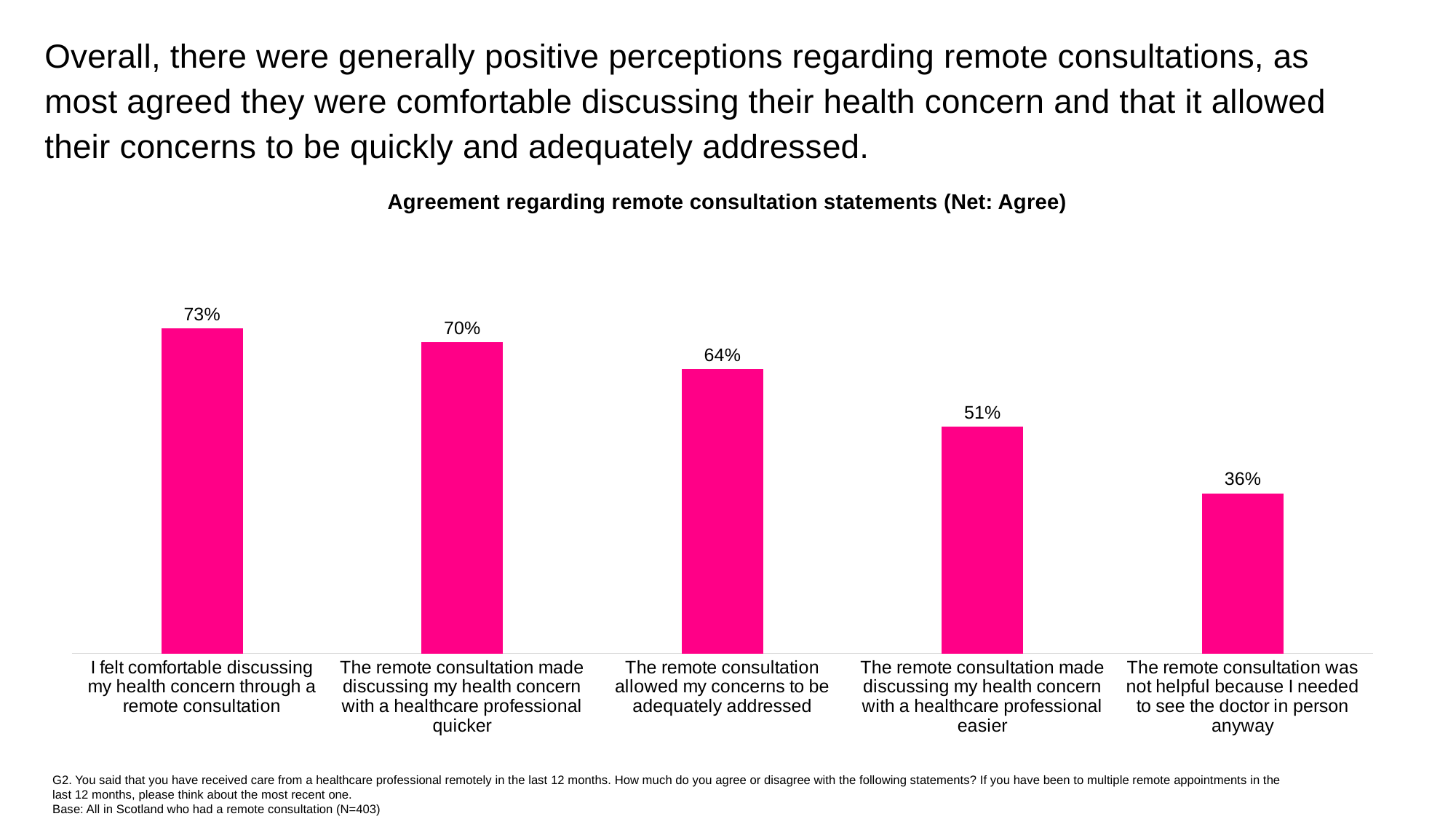
Which statement has the lowest net agreement? The remote consultation was not helpful because I needed to see the doctor in person anyway Which has higher net agreement: 'The remote consultation allowed my concerns to be adequately addressed' or 'The remote consultation made discussing my health concern with a healthcare professional easier'? The remote consultation allowed my concerns to be adequately addressed What is the title of the chart? Agreement regarding remote consultation statements (Net: Agree) What is the difference between the highest and lowest net agreement values in the chart? 37 percentage points What is the difference in net agreement between 'The remote consultation made discussing my health concern with a healthcare professional quicker' and 'The remote consultation made discussing my health concern with a healthcare professional easier'? 19 percentage points What percentage agreed with the statement 'I felt comfortable discussing my health concern through a remote consultation'? 73% What is the net agreement for 'The remote consultation allowed my concerns to be adequately addressed'? 64% What percentage agreed that 'The remote consultation was not helpful because I needed to see the doctor in person anyway'? 36% Do the values rise or fall moving from left to right across the chart? Fall Which statement has the highest net agreement? I felt comfortable discussing my health concern through a remote consultation How many statements are shown in the chart? 5 What type of chart is shown on the slide? Bar chart